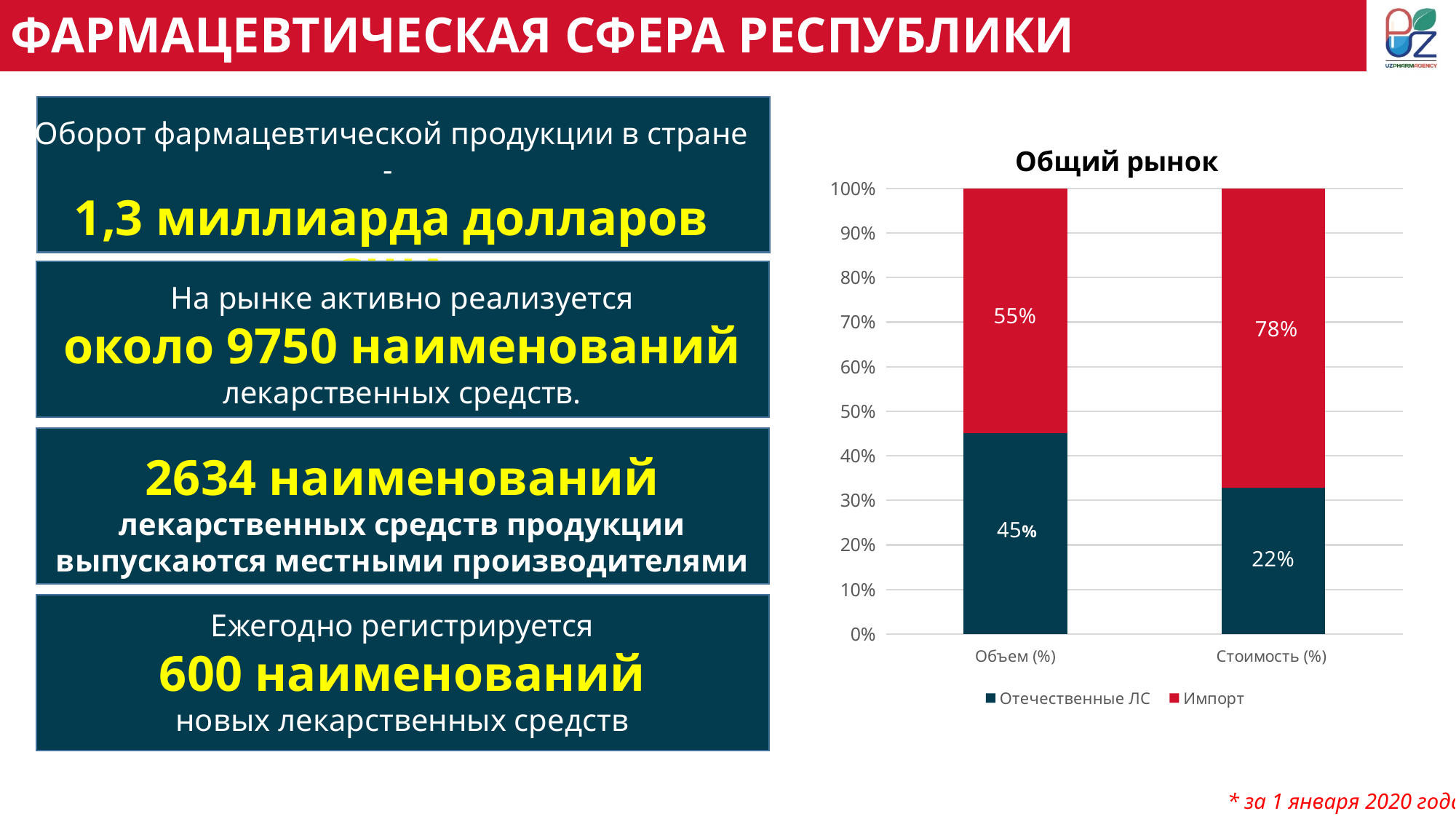
What is the value for Импорт in the Стоимость (%) category? 78% In which category is the Отечественные ЛС share lowest? Стоимость (%) How many series does the legend list? 2 What is the value for Отечественные ЛС in the Объем (%) category? 45% What is the title of the chart? Общий рынок Which is larger in the Объем (%) category: Отечественные ЛС or Импорт? Импорт What is the difference between the Импорт values for Стоимость (%) and Объем (%)? 23% What type of chart is shown? stacked bar chart What is the value for Импорт in the Объем (%) category? 55% What is the value for Отечественные ЛС in the Стоимость (%) category? 22% How many categories are shown on the x axis? 2 In which category is the Импорт share highest? Стоимость (%)